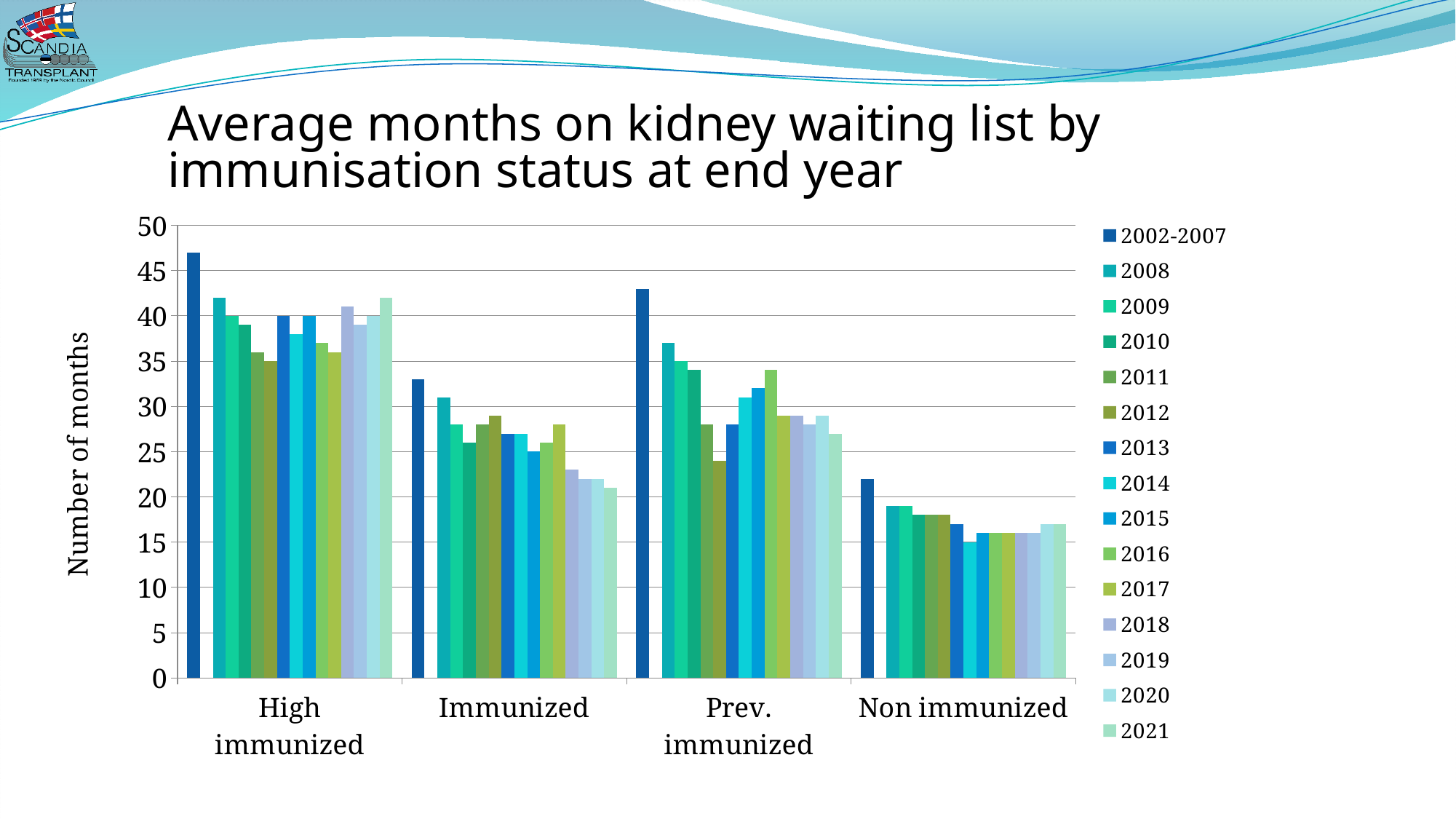
Is the value for 2002-2007 in the Non immunized category greater or less than 20? greater Is the value for 2002-2007 in the High immunized category greater or less than 45? greater What kind of chart is shown on the slide? bar chart What is the first entry in the legend? 2002-2007 Is the value for 2002-2007 in the Immunized category greater or less than 30? greater How many immunisation status categories are shown on the x axis? 4 Within the Prev. immunized category, which series has the highest value? 2002-2007 Which category has the lowest value for the 2002-2007 series? Non immunized What is the label on the vertical axis? Number of months Which is larger: the 2002-2007 value for High immunized or the 2002-2007 value for Non immunized? High immunized How many series does the legend list? 15